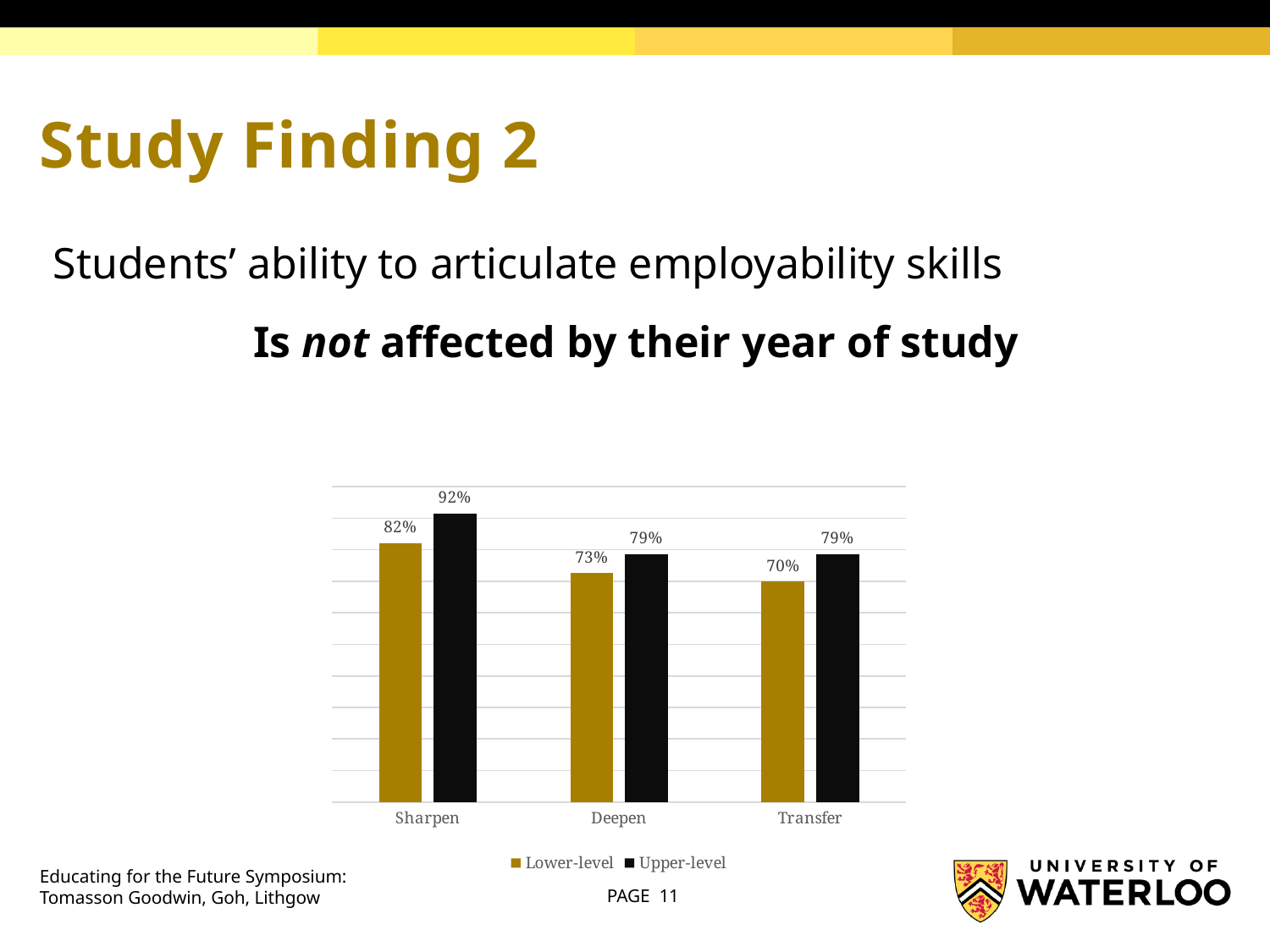
Which category has the highest Upper-level value? Sharpen Which colour represents the Upper-level series in the legend? Black What is the difference between the Upper-level and Lower-level values for Sharpen? 10% What is the Upper-level value for Deepen? 79% Which is larger for Deepen, the Lower-level value or the Upper-level value? Upper-level What is the Lower-level value for Transfer? 70% Which category has the lowest Lower-level value? Transfer How many categories are shown on the x axis? 3 What kind of chart is shown on the slide? Bar chart What is the Lower-level value for Sharpen? 82% How many series does the legend list? 2 What is the difference between the Lower-level values for Sharpen and Transfer? 12%